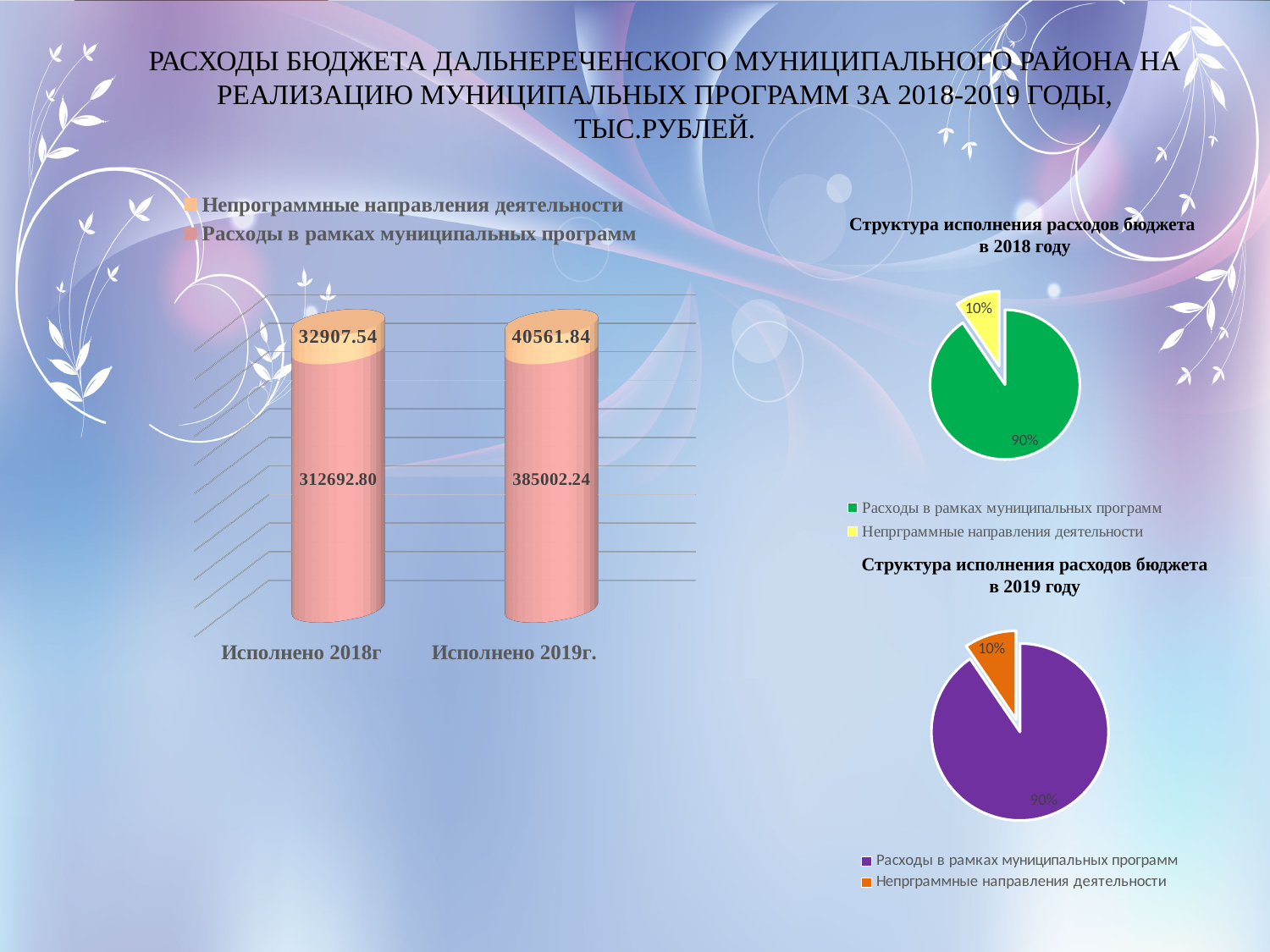
In the bar chart on the left, what is the total of the stacked bar for Исполнено 2019г.? 425564.08 In the pie chart titled 'Структура исполнения расходов бюджета в 2019 году', what share does Непрграммные направления деятельности have? 10% In the bar chart on the left, which category has the larger value for Непрограммные направления деятельности: Исполнено 2018г or Исполнено 2019г.? Исполнено 2019г. In the bar chart on the left, what is the value for Непрограммные направления деятельности for Исполнено 2018г? 32907.54 In the bar chart on the left, how many series does the legend list? 2 In the pie chart titled 'Структура исполнения расходов бюджета в 2019 году', what colour is the slice for Расходы в рамках муниципальных программ? Purple In the bar chart on the left, what is the value for Непрограммные направления деятельности for Исполнено 2019г.? 40561.84 What kind of chart is the chart on the left of the slide? Bar chart In the bar chart on the left, what is the value for Расходы в рамках муниципальных программ for Исполнено 2018г? 312692.80 In the bar chart on the left, what is the difference between the Расходы в рамках муниципальных программ values for Исполнено 2019г. and Исполнено 2018г? 72309.44 In the bar chart on the left, what is the total of the stacked bar for Исполнено 2018г? 345600.34 In the pie chart titled 'Структура исполнения расходов бюджета в 2018 году', what share does Расходы в рамках муниципальных программ have? 90%